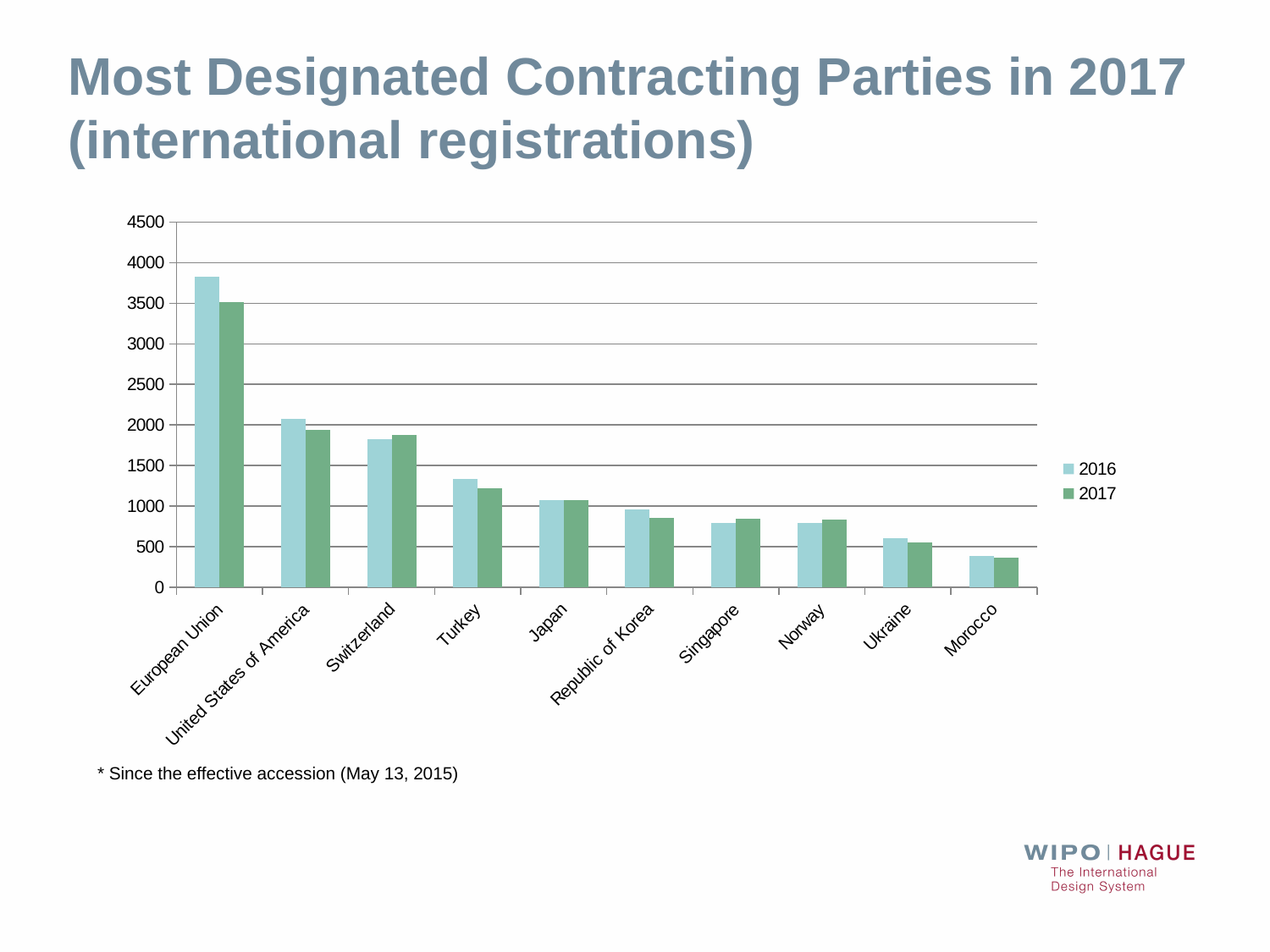
For Switzerland, which year has the larger value, 2016 or 2017? 2017 Which contracting party has the lowest value for 2017? Morocco Is the 2016 value for Turkey greater or less than 1000? greater For the European Union, which year has the larger value, 2016 or 2017? 2016 What kind of chart is shown on the slide? bar chart Is the 2017 value for Morocco greater or less than 500? less Which contracting party has the highest value for 2017? European Union How many contracting parties are shown on the x axis? 10 Is the 2017 value for the United States of America greater or less than 2000? less How many series does the legend list? 2 Do the 2017 values generally rise or fall from left to right along the x axis? fall